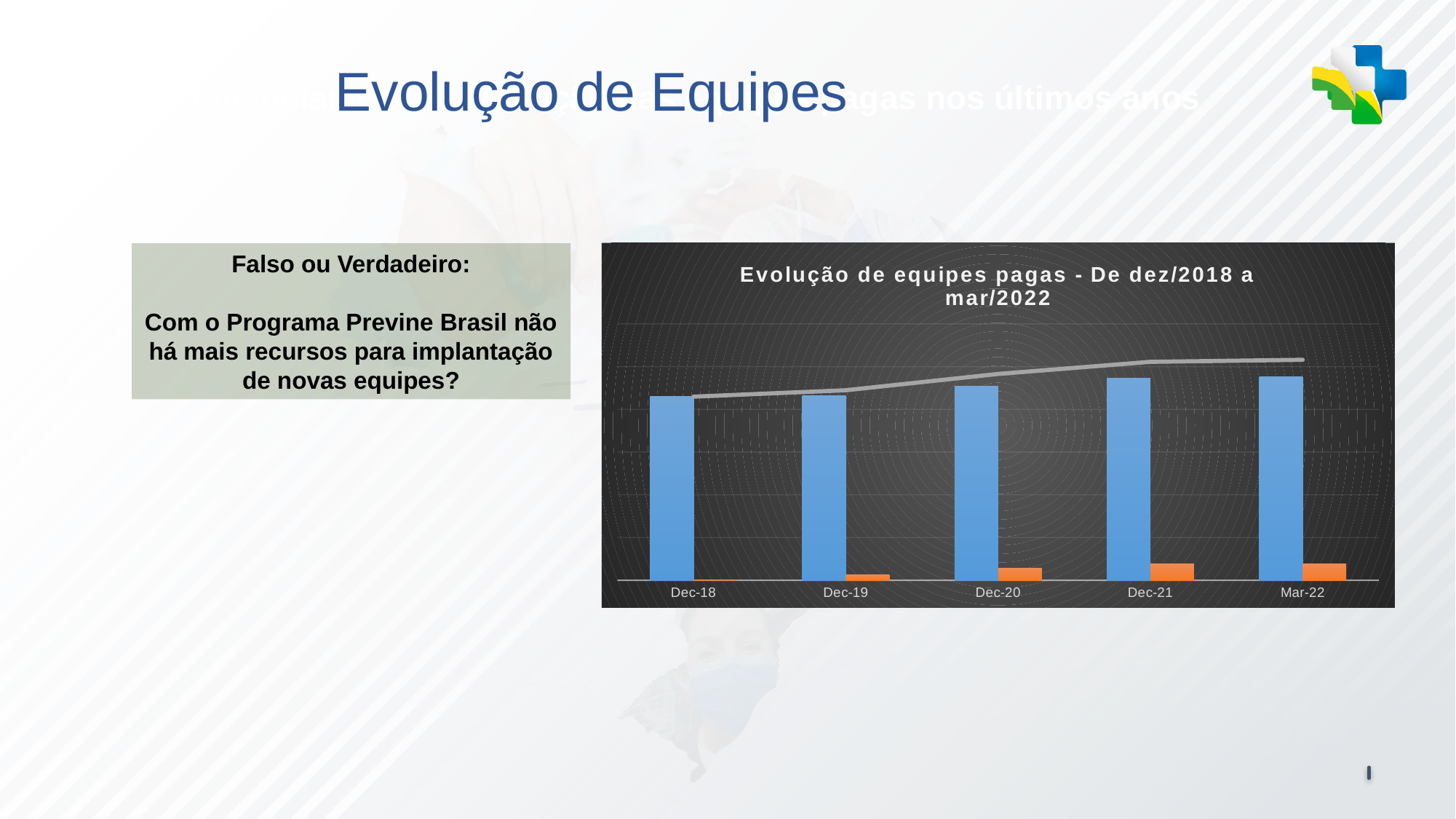
What is the title of the chart? Evolução de equipes pagas - De dez/2018 a mar/2022 What is the first category on the x axis of the chart? Dec-18 Does the grey line rise or fall from Dec-18 to Mar-22? rise Do the blue bars rise or fall from Dec-18 to Mar-22? rise Do the orange bars rise or fall from Dec-19 to Dec-21? rise How many categories are shown on the x axis of the chart? 5 Which is larger, the blue bar for Dec-20 or the blue bar for Dec-18? Dec-20 Which is larger, the blue bar for Dec-21 or the blue bar for Dec-19? Dec-21 Among the categories with a visible orange bar, which has the smallest orange bar? Dec-19 What kind of chart is shown on the slide? combination bar and line chart Which is larger, the orange bar for Dec-21 or the orange bar for Dec-19? Dec-21